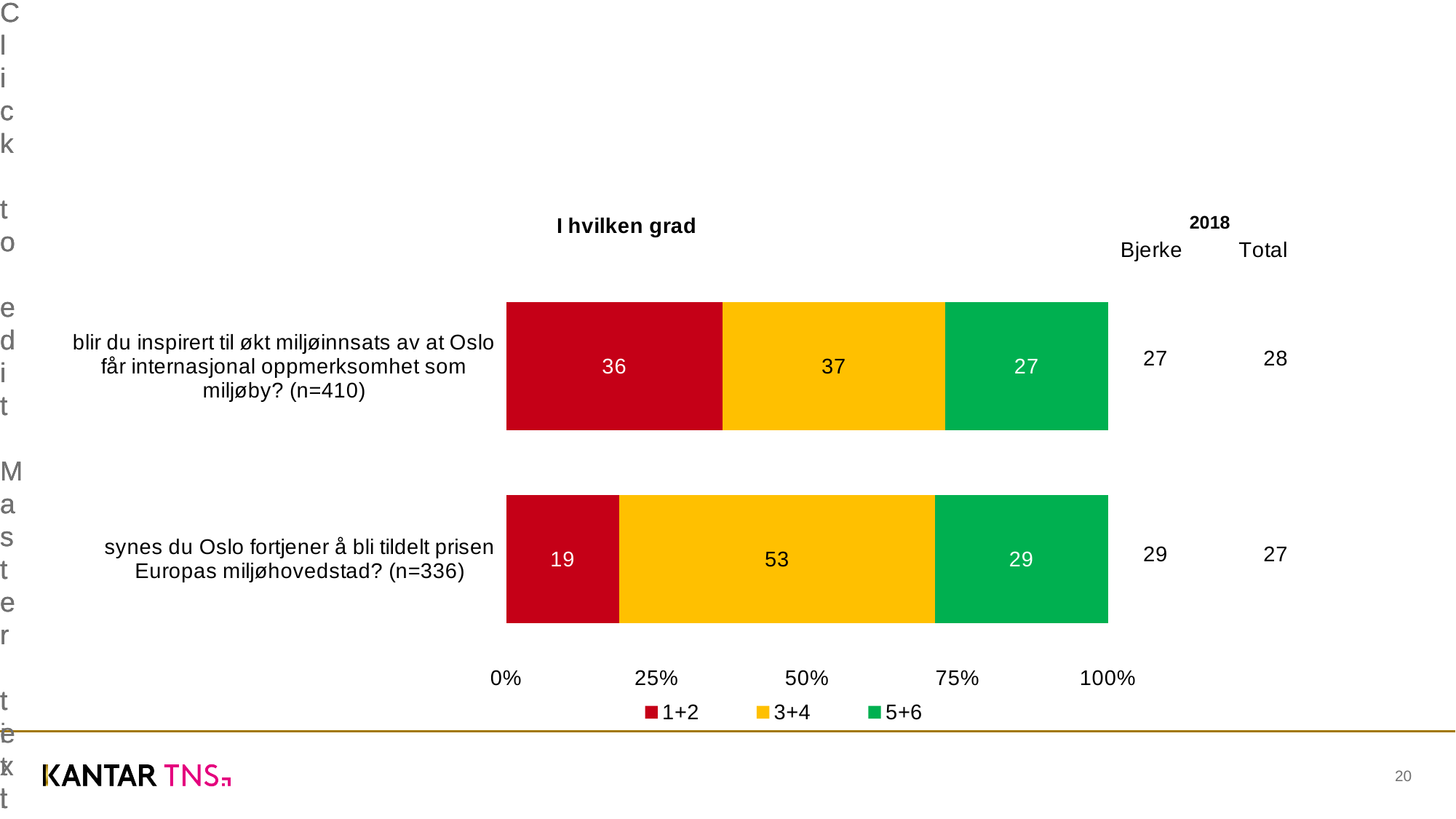
How many series does the legend list? 3 What is the value of the 1+2 segment for "blir du inspirert til økt miljøinnsats av at Oslo får internasjonal oppmerksomhet som miljøby? (n=410)"? 36 What is the value of the 5+6 segment for "blir du inspirert til økt miljøinnsats av at Oslo får internasjonal oppmerksomhet som miljøby? (n=410)"? 27 Which category has the larger 1+2 segment? blir du inspirert til økt miljøinnsats av at Oslo får internasjonal oppmerksomhet som miljøby? (n=410) What is the title shown above the chart? I hvilken grad Is the 1+2 value for "synes du Oslo fortjener å bli tildelt prisen Europas miljøhovedstad? (n=336)" larger or smaller than its 5+6 value? smaller What is the total of the stacked bar for "synes du Oslo fortjener å bli tildelt prisen Europas miljøhovedstad? (n=336)"? 101 How many categories (questions) are plotted in the chart? 2 What kind of chart is shown on the slide? stacked bar chart Which category has the smaller 3+4 segment? blir du inspirert til økt miljøinnsats av at Oslo får internasjonal oppmerksomhet som miljøby? (n=410) What is the difference between the 3+4 values of the two categories? 16 What is the value of the 3+4 segment for "synes du Oslo fortjener å bli tildelt prisen Europas miljøhovedstad? (n=336)"? 53